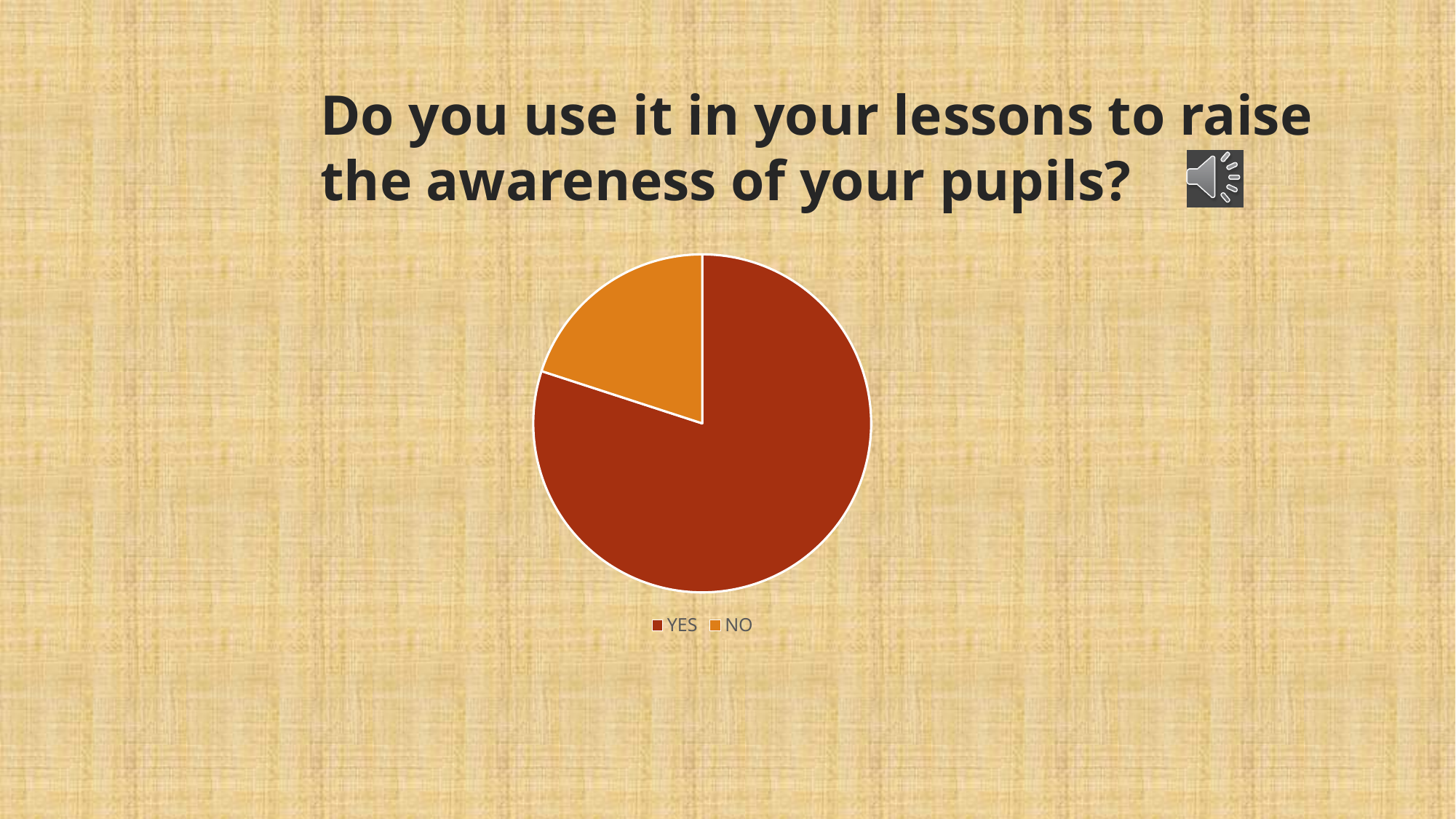
How many slices does the pie chart have? 2 Which slice is larger, YES or NO? YES Which category has the smallest slice of the pie? NO What kind of chart is shown on the slide? pie chart What colour is the YES slice? dark red How many entries does the legend list? 2 Which category has the largest slice of the pie? YES What are the two categories listed in the legend? YES and NO